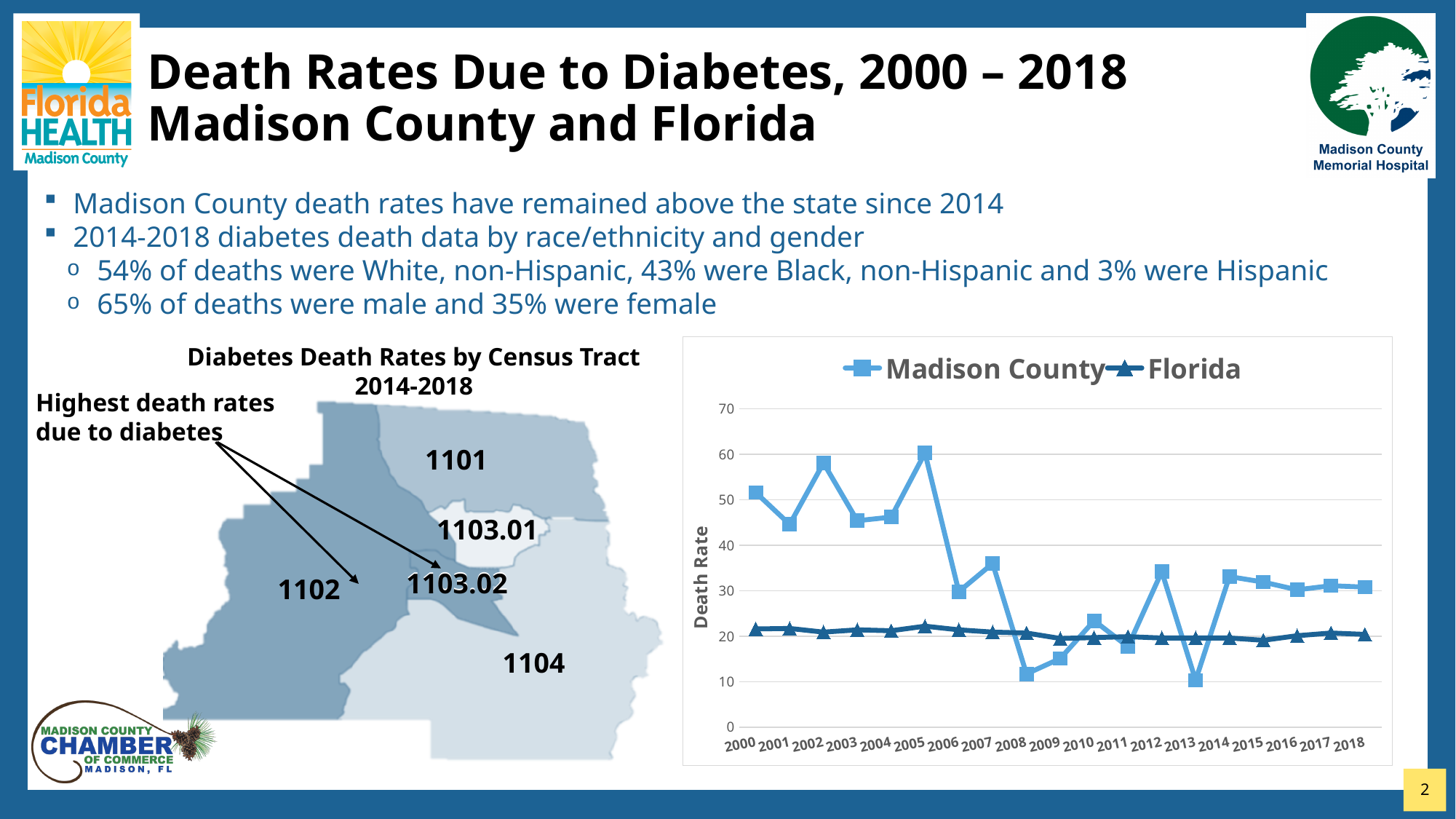
In the line chart, how many years are plotted along the x axis? 19 In the line chart, how many series does the legend list? 2 In the line chart, which is larger in 2018, the Madison County death rate or the Florida death rate? Madison County In the line chart, is the Madison County death rate in 2008 greater or less than 20? less In the line chart, is the Madison County death rate in 2005 greater or less than 50? greater In the line chart, what is the label on the vertical axis? Death Rate In the line chart, which year has the lowest Madison County death rate? 2013 In the line chart, which year has the highest Madison County death rate? 2005 In the line chart, is the Florida death rate in 2000 greater or less than 30? less In the line chart, does the Madison County death rate overall rise or fall from 2000 to 2018? fall What kind of chart is the chart comparing Madison County and Florida death rates? line chart In the line chart, which is larger in 2008, the Madison County death rate or the Florida death rate? Florida